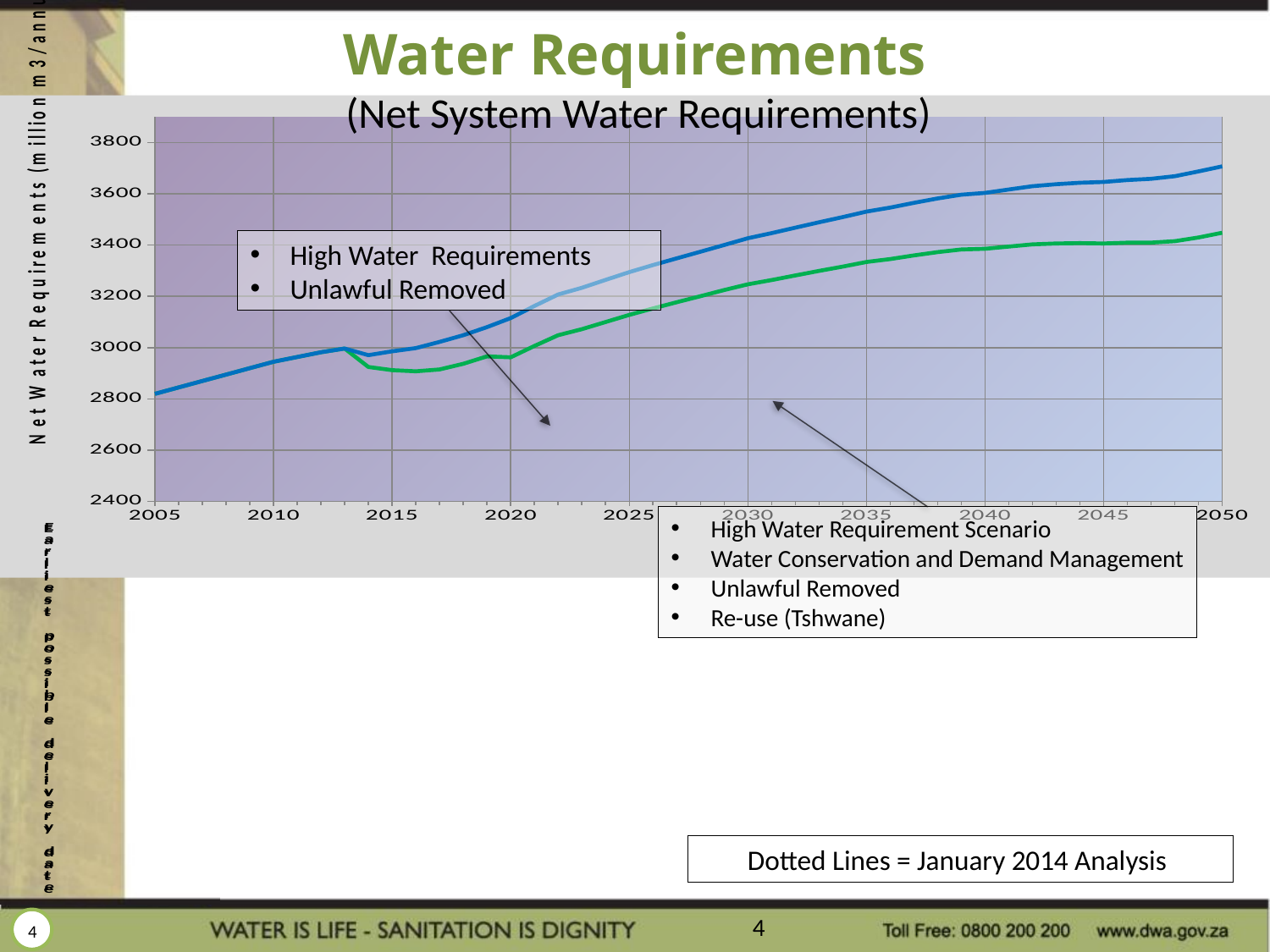
Is the value of the blue line in 2050 greater or less than 3600? greater What is the first year labelled on the x axis? 2005 How many year labels are shown on the x axis? 10 Is the value of the blue line in 2005 greater or less than 3000? less Is the value of the blue line in 2020 greater or less than 3000? greater What kind of chart is shown on the slide? line chart Do the plotted lines generally rise or fall from 2005 to 2050? rise How many lines are plotted on the chart? 2 What is the title shown above the chart? (Net System Water Requirements) Which line is higher in 2050, the blue line or the green line? blue line